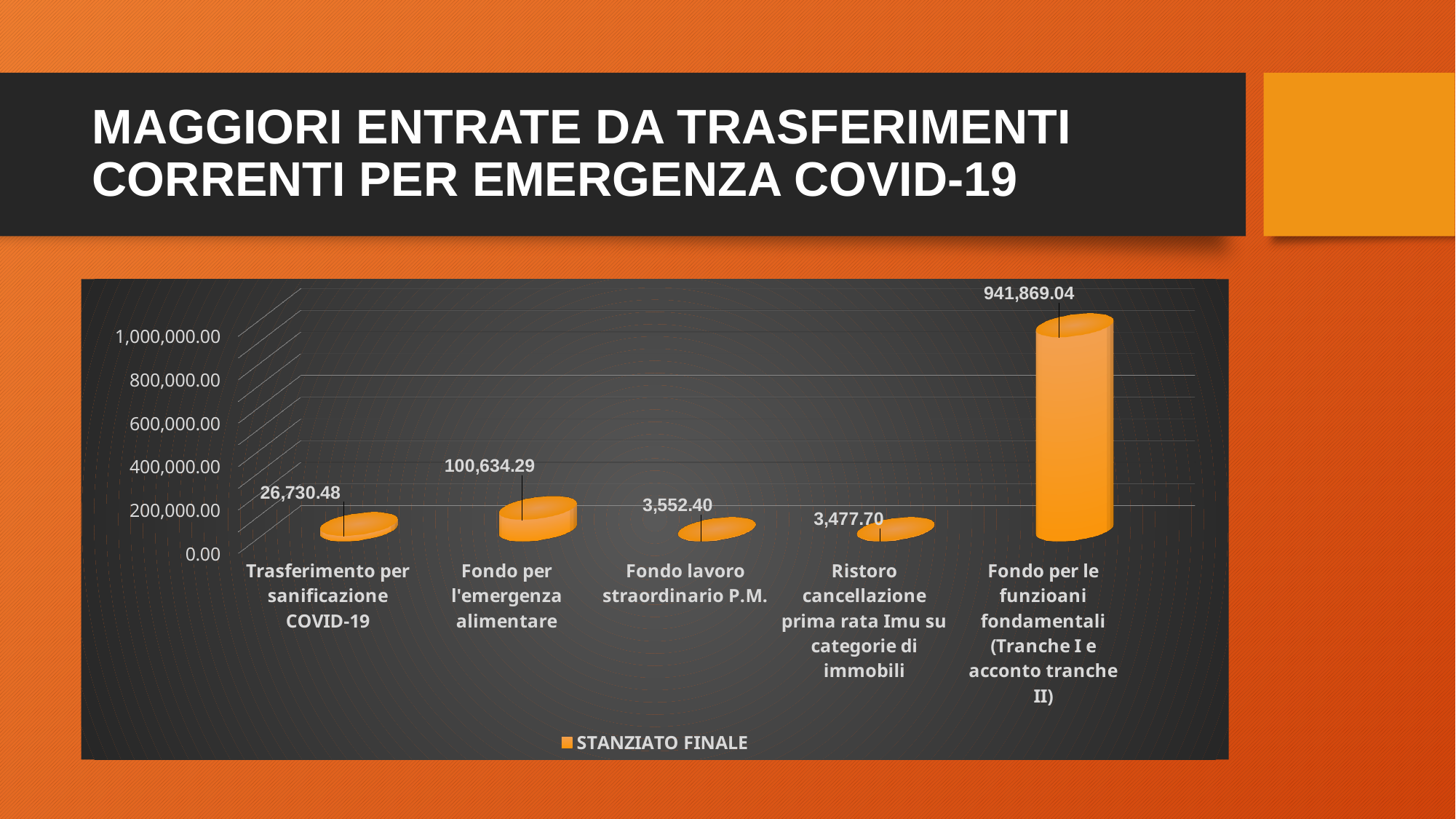
What is the value for Fondo per l'emergenza alimentare? 100,634.29 How many categories are shown on the x axis? 5 What is the value for Fondo per le funzioani fondamentali (Tranche I e acconto tranche II)? 941,869.04 Which is larger, the value for Fondo per l'emergenza alimentare or the value for Trasferimento per sanificazione COVID-19? Fondo per l'emergenza alimentare What is the value for Trasferimento per sanificazione COVID-19? 26,730.48 What is the value for Fondo lavoro straordinario P.M.? 3,552.40 What series does the legend list? STANZIATO FINALE Is the value for Fondo per le funzioani fondamentali (Tranche I e acconto tranche II) greater or less than 800,000.00? greater What is the value for Ristoro cancellazione prima rata Imu su categorie di immobili? 3,477.70 What is the difference between the value for Fondo per l'emergenza alimentare and the value for Trasferimento per sanificazione COVID-19? 73,903.81 Which category has the highest value? Fondo per le funzioani fondamentali (Tranche I e acconto tranche II) What is the difference between the value for Fondo per le funzioani fondamentali (Tranche I e acconto tranche II) and the value for Fondo per l'emergenza alimentare? 841,234.75